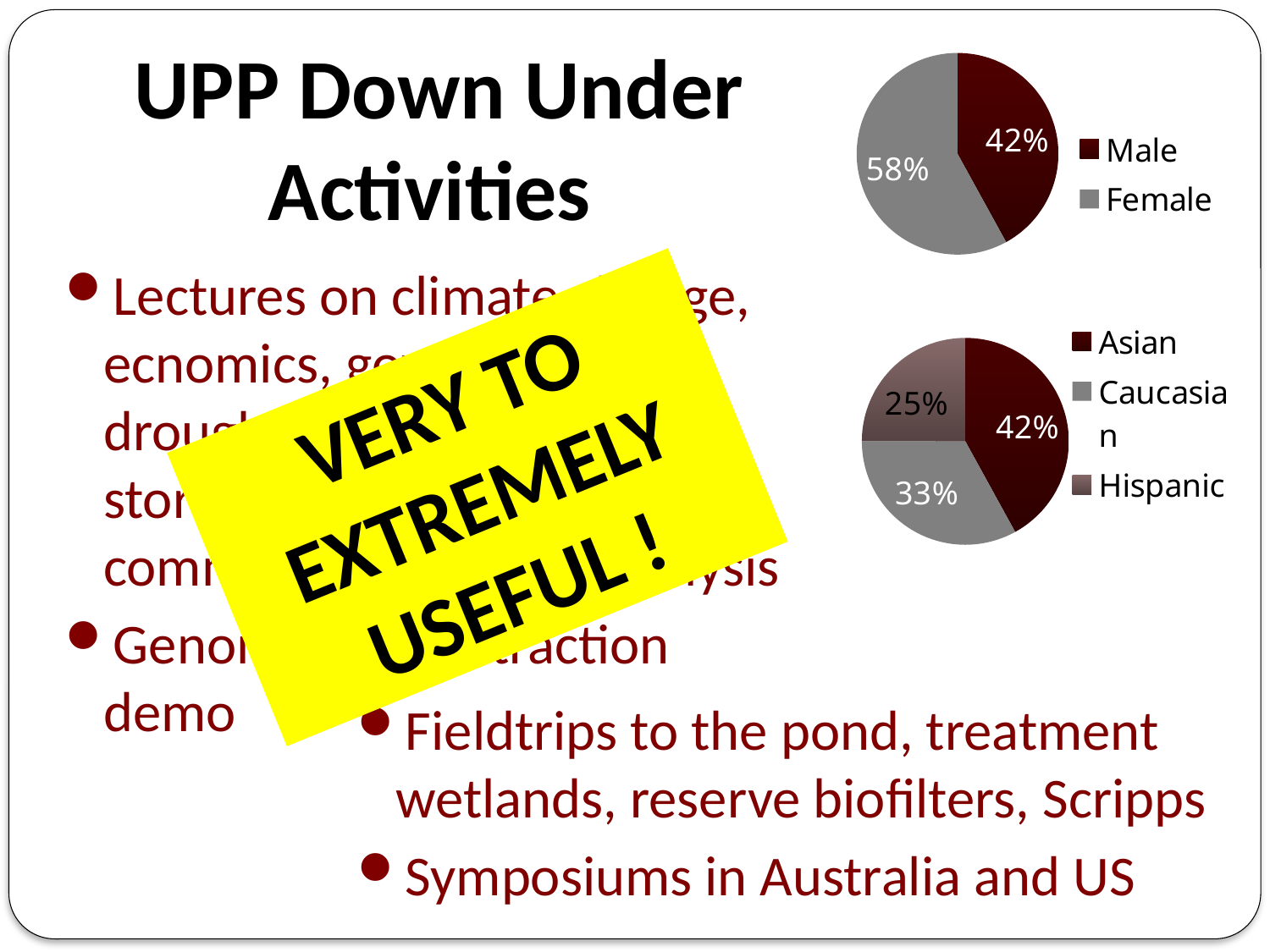
In the top pie chart, what is the share for Female? 58% In the bottom pie chart, what is the share for Caucasian? 33% What type of chart is the bottom chart on the slide? Pie chart In the bottom pie chart, which category has the smallest share? Hispanic In the bottom pie chart, which category has the largest share? Asian In the bottom pie chart, what is the difference between the Asian and Hispanic shares? 17% In the bottom pie chart, what is the share for Hispanic? 25% How many categories does the legend of the top pie chart list? 2 In the top pie chart, which category has the larger share? Female In the top pie chart, what is the share for Male? 42% In the bottom pie chart, what is the share for Asian? 42% In the top pie chart, what is the difference between the Female and Male shares? 16%